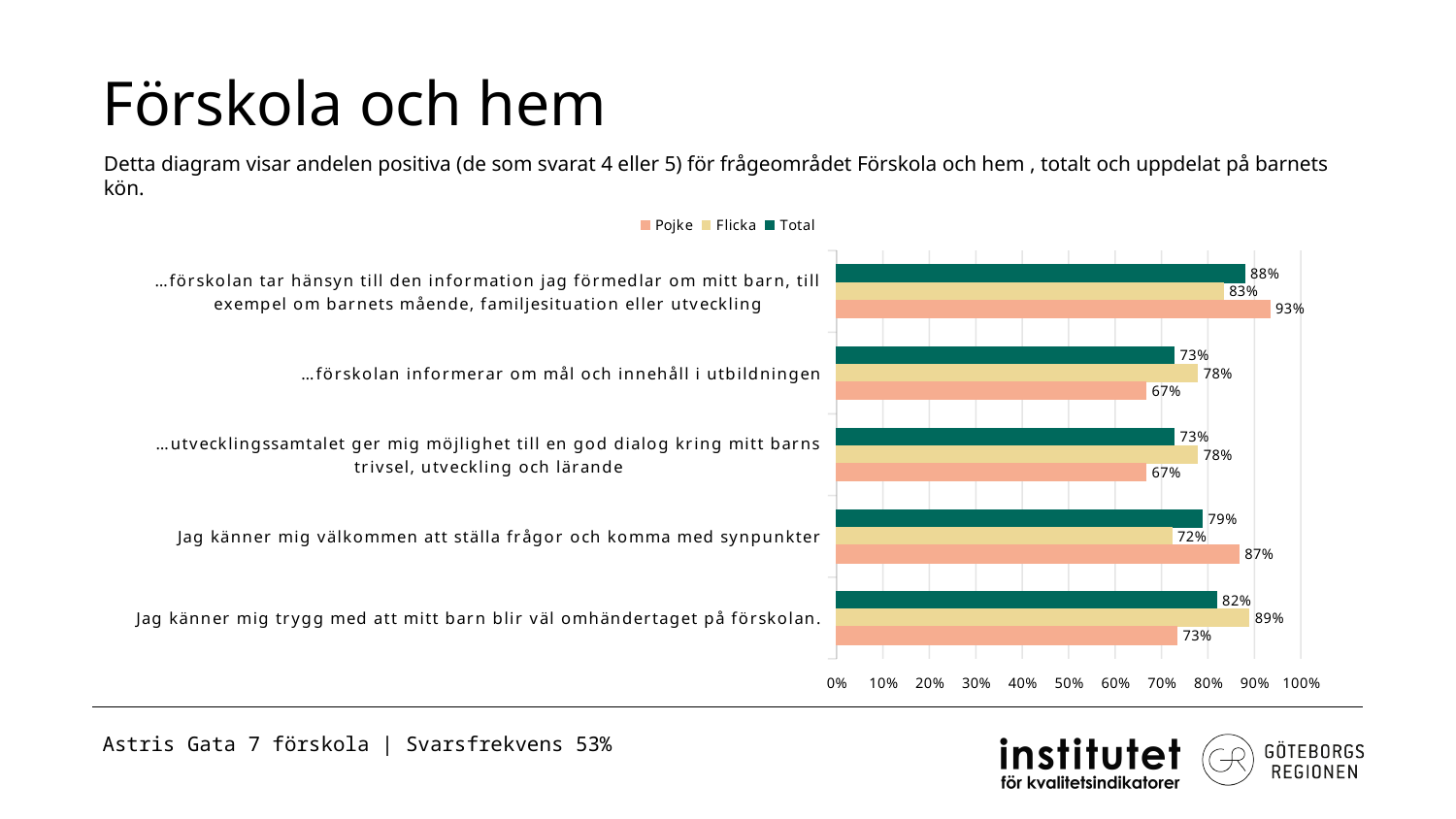
What kind of chart is shown on the slide? bar chart Is the Total value for "…förskolan informerar om mål och innehåll i utbildningen" greater or less than 80%? less What is the Flicka value for "Jag känner mig välkommen att ställa frågor och komma med synpunkter"? 72% What is the difference between the Flicka and Pojke values for "Jag känner mig trygg med att mitt barn blir väl omhändertaget på förskolan."? 16% How many categories are shown on the chart? 5 How many series does the legend list? 3 Which category has the lowest Flicka value? Jag känner mig välkommen att ställa frågor och komma med synpunkter What is the Pojke value for "…förskolan informerar om mål och innehåll i utbildningen"? 67% Which series is shown in dark green in the legend? Total What is the Total value for "Jag känner mig trygg med att mitt barn blir väl omhändertaget på förskolan."? 82% For "Jag känner mig välkommen att ställa frågor och komma med synpunkter", which is larger, the Pojke value or the Flicka value? Pojke Which category has the highest Pojke value? …förskolan tar hänsyn till den information jag förmedlar om mitt barn, till exempel om barnets mående, familjesituation eller utveckling